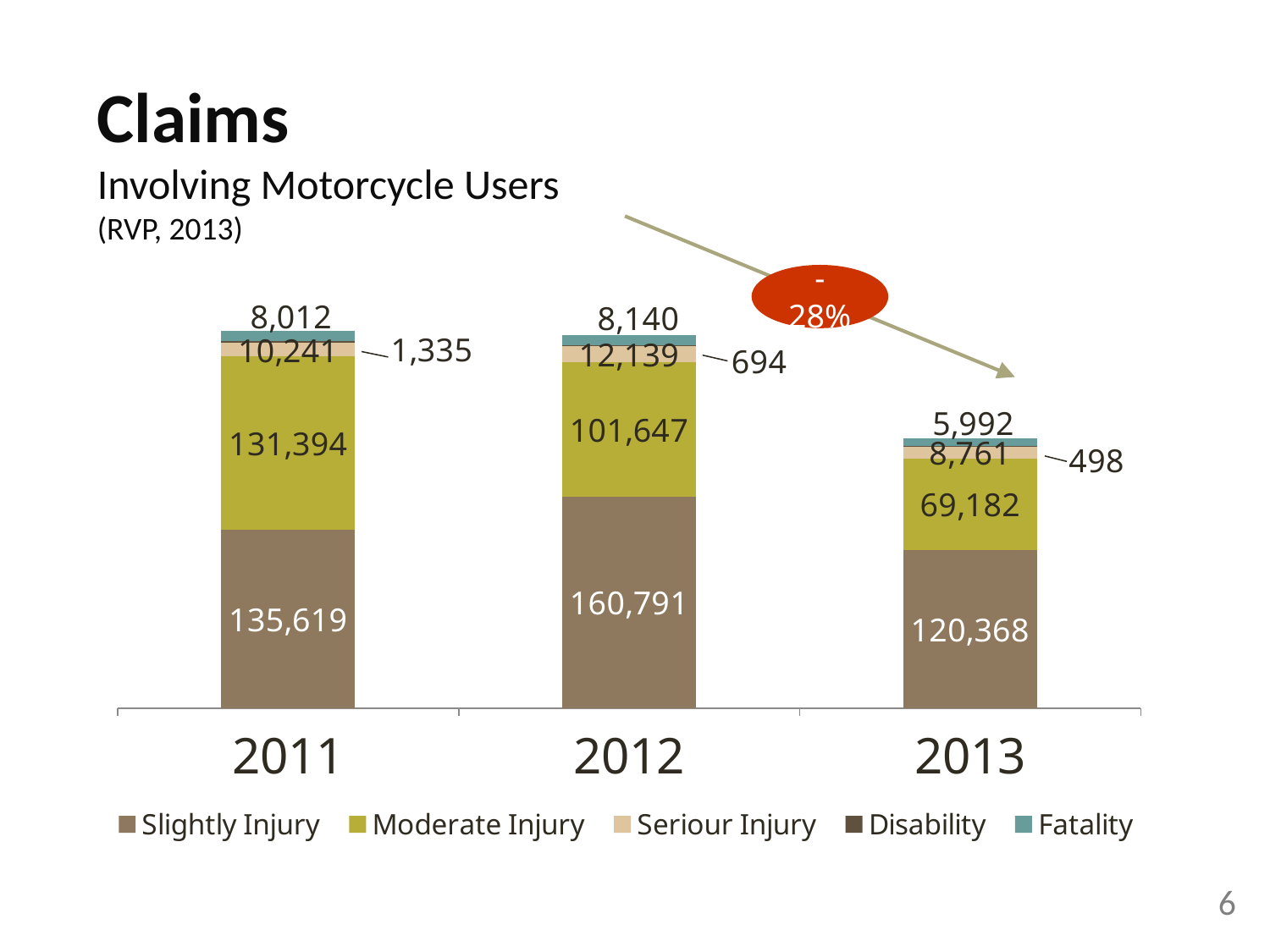
How many series does the legend list? 5 What is the Fatality value for 2011? 8,012 What is the Moderate Injury value for 2013? 69,182 How many years are shown on the x axis? 3 Which year has the highest Slightly Injury value? 2012 What is the difference between the Moderate Injury values for 2011 and 2012? 29,747 Which year has the lowest Seriour Injury value? 2013 What is the Slightly Injury value for 2012? 160,791 Is the Slightly Injury value larger in 2011 or in 2013? 2011 What is the Disability value for 2012? 694 What is the total of the stacked bar for 2013? 204,801 What type of chart is shown on the slide? stacked bar chart